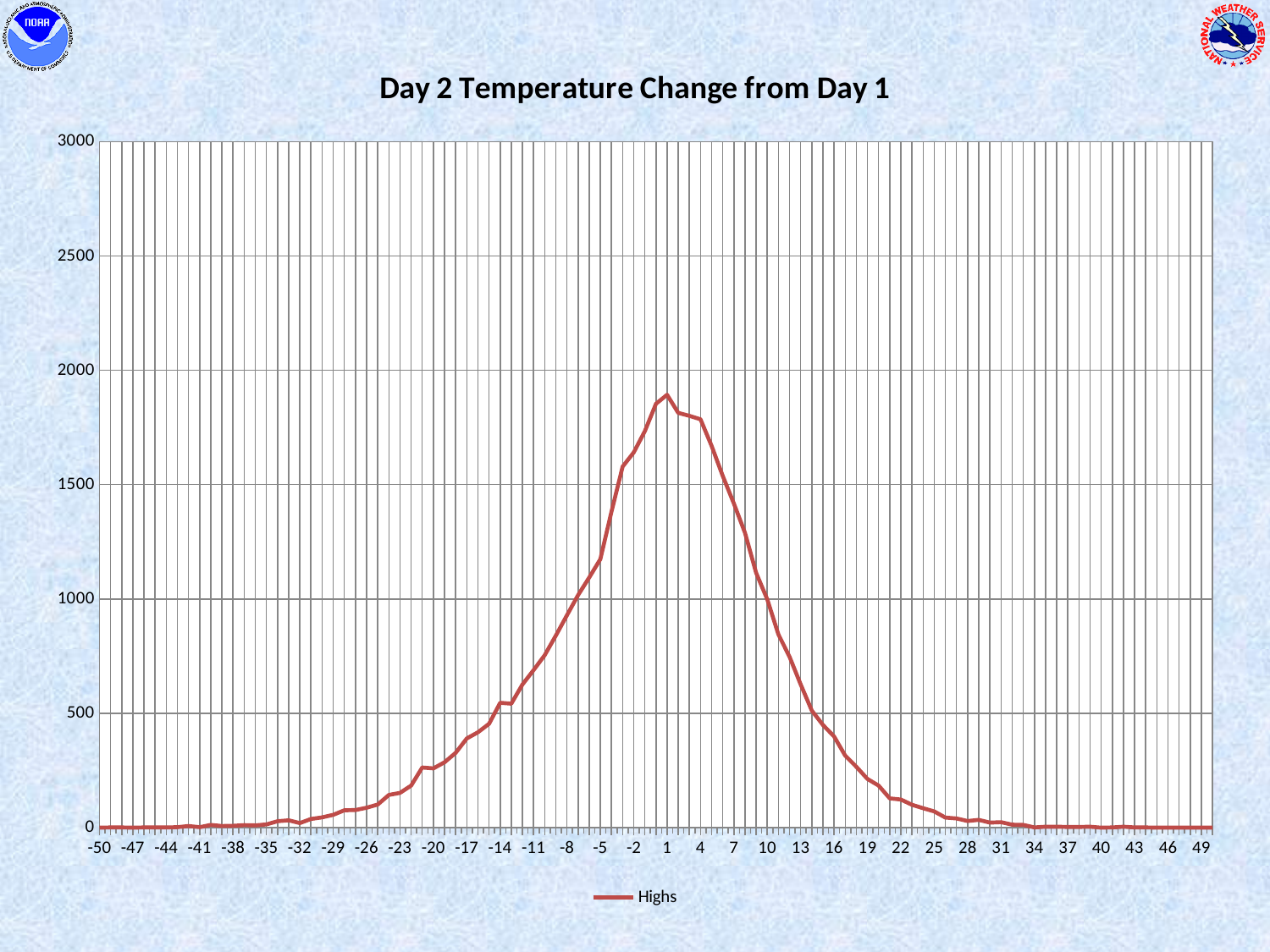
Is the value for Highs at 13 greater or less than 1000? less Is the value for Highs at 1 greater or less than 1500? greater Which is larger, the Highs value at -2 or at 4? 4 Is the value for Highs at -5 greater or less than 1000? greater Do the Highs values rise or fall along the x axis from 1 to 49? fall Which is larger, the Highs value at -11 or at 13? -11 At which x-axis value does the Highs line reach its highest point? 1 What is the title of the chart? Day 2 Temperature Change from Day 1 How many series does the legend list? 1 What kind of chart is shown on the slide? line chart What is the name of the series shown in the legend? Highs